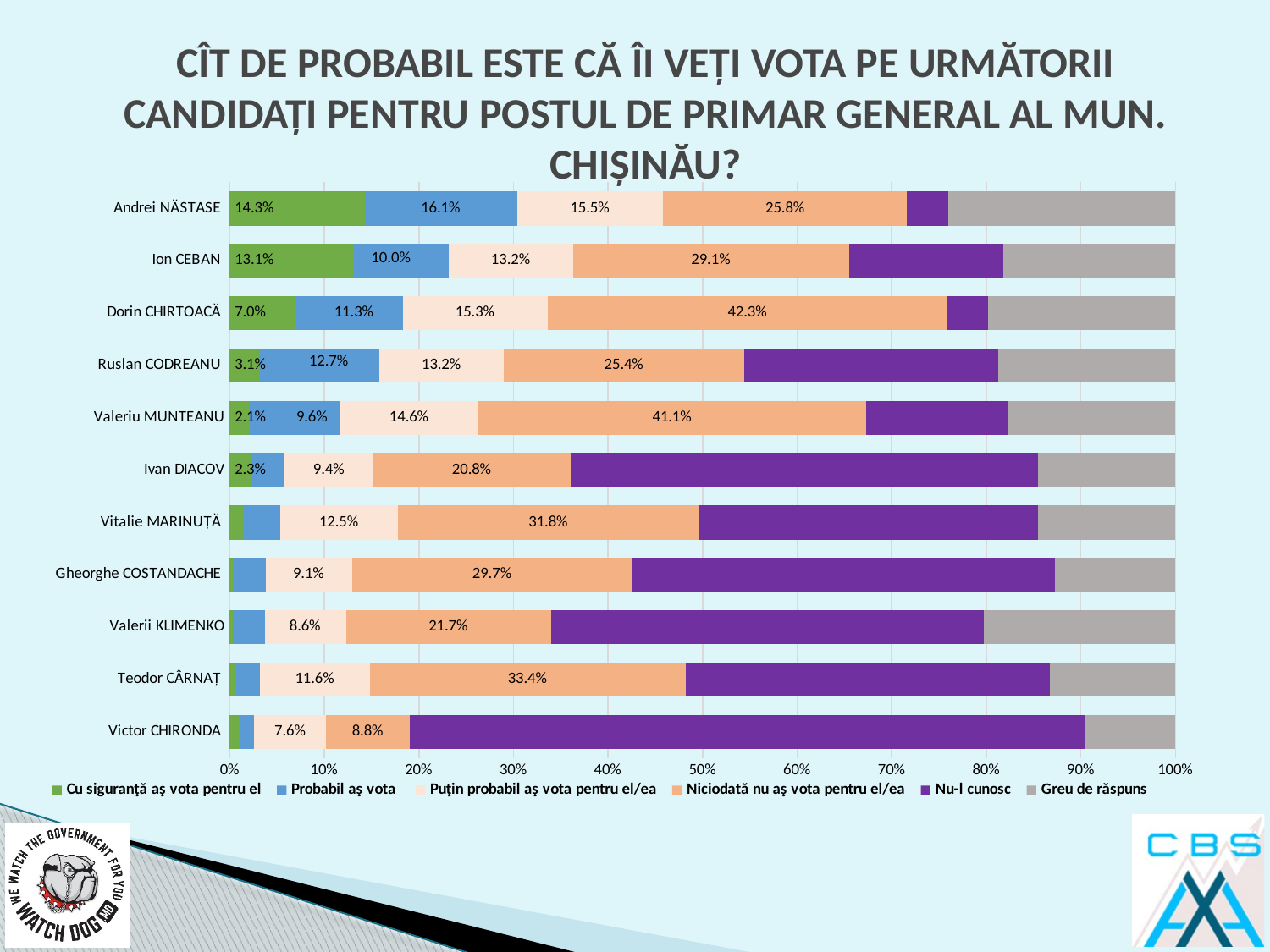
Which candidate has the highest "Niciodată nu aș vota pentru el/ea" share? Dorin CHIRTOACĂ What percentage of respondents said "Cu siguranță aș vota pentru el" for Andrei NĂSTASE? 14.3% Is the "Nu-l cunosc" value for Victor CHIRONDA greater or less than 60%? greater How many series does the legend list? 6 How many candidates are shown in the chart? 11 What is the "Niciodată nu aș vota pentru el/ea" value for Dorin CHIRTOACĂ? 42.3% What is the "Puțin probabil aș vota pentru el/ea" value for Teodor CÂRNAȚ? 11.6% What kind of chart is shown on the slide? Stacked bar chart Which candidate has the highest "Cu siguranță aș vota pentru el" share? Andrei NĂSTASE What is the difference between the "Niciodată nu aș vota pentru el/ea" values for Ion CEBAN and Andrei NĂSTASE? 3.3% What is the "Probabil aș vota" value for Ruslan CODREANU? 12.7% Which is larger: the "Probabil aș vota" value for Andrei NĂSTASE or for Ion CEBAN? Andrei NĂSTASE